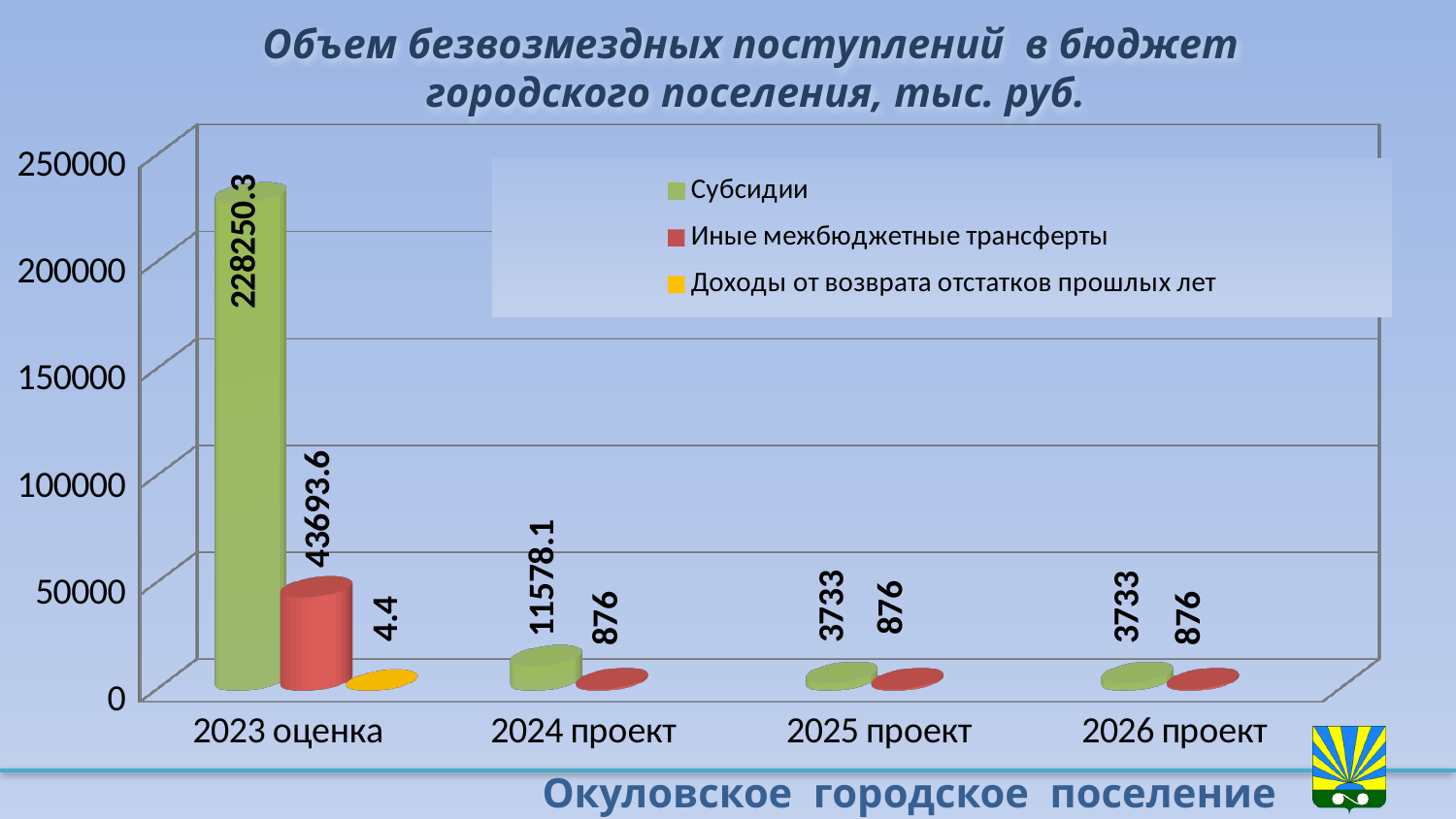
What is the value of Иные межбюджетные трансферты for 2023 оценка? 43693.6 Which is larger for 2023 оценка: Субсидии or Иные межбюджетные трансферты? Субсидии What is the value of Иные межбюджетные трансферты for 2025 проект? 876 What kind of chart is shown on the slide? bar chart What is the value of Доходы от возврата отстатков прошлых лет for 2023 оценка? 4.4 What is the value of Субсидии for 2023 оценка? 228250.3 How many series does the legend list? 3 Is the value of Субсидии for 2023 оценка greater or less than 200000? greater What is the value of Субсидии for 2024 проект? 11578.1 How many categories are shown on the x axis? 4 Which category has the highest value for Субсидии? 2023 оценка What is the difference between the Субсидии values for 2024 проект and 2025 проект? 7845.1